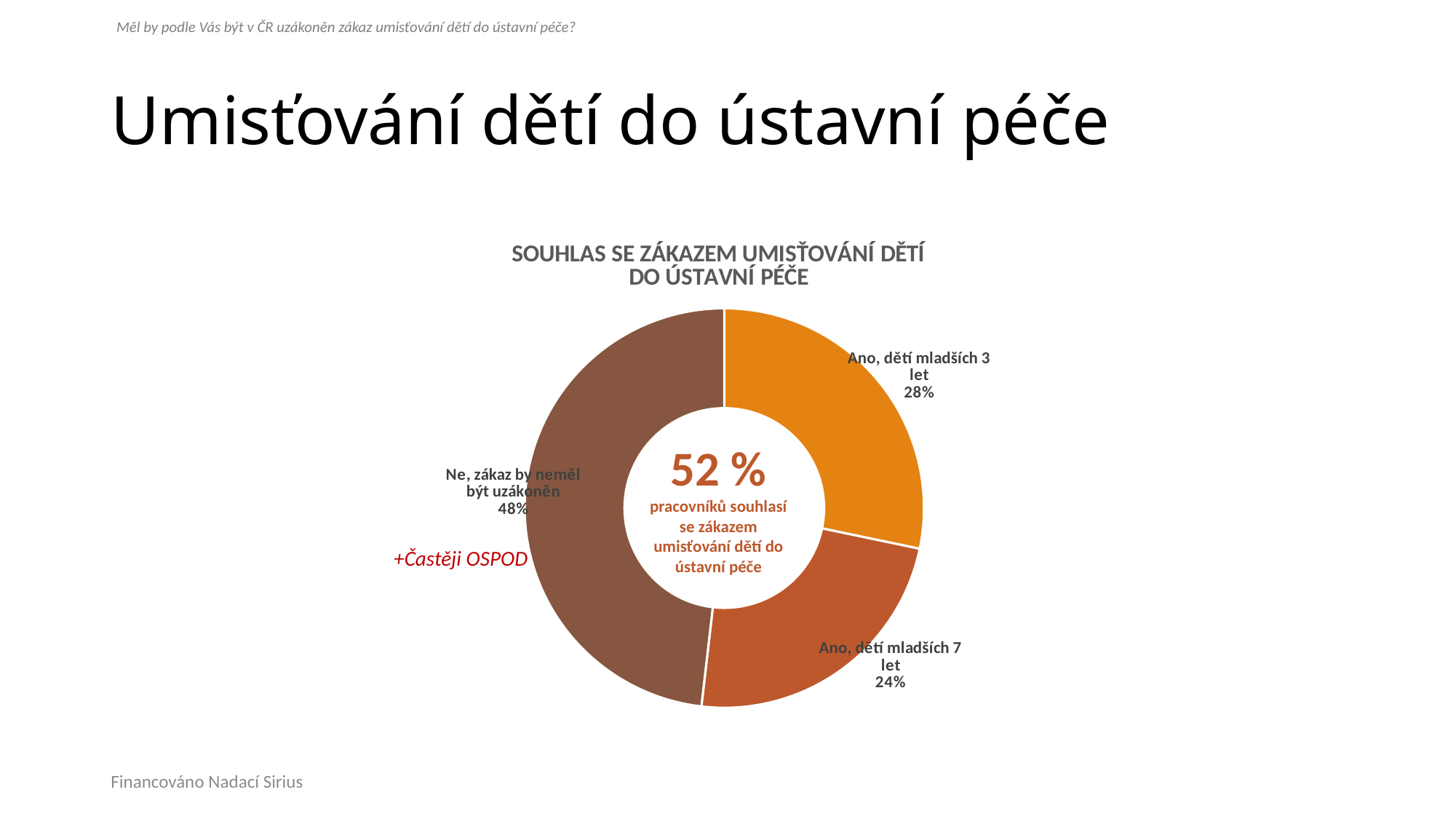
What is the combined share of the two "Ano" categories? 52% Which category has the largest share of the chart? Ne, zákaz by neměl být uzákoněn What share of the chart is labelled "Ano, dětí mladších 3 let"? 28% What percentage is printed in the centre of the doughnut chart? 52 % What kind of chart is shown on the slide? Doughnut (pie) chart What is the difference in percentage points between "Ne, zákaz by neměl být uzákoněn" and "Ano, dětí mladších 3 let"? 20 percentage points What share of the chart is labelled "Ne, zákaz by neměl být uzákoněn"? 48% What is the title of the chart? SOUHLAS SE ZÁKAZEM UMISŤOVÁNÍ DĚTÍ DO ÚSTAVNÍ PÉČE How many categories does the chart show? 3 Which is larger: the share for "Ano, dětí mladších 3 let" or for "Ano, dětí mladších 7 let"? Ano, dětí mladších 3 let What share of the chart is labelled "Ano, dětí mladších 7 let"? 24% Which category has the smallest share of the chart? Ano, dětí mladších 7 let